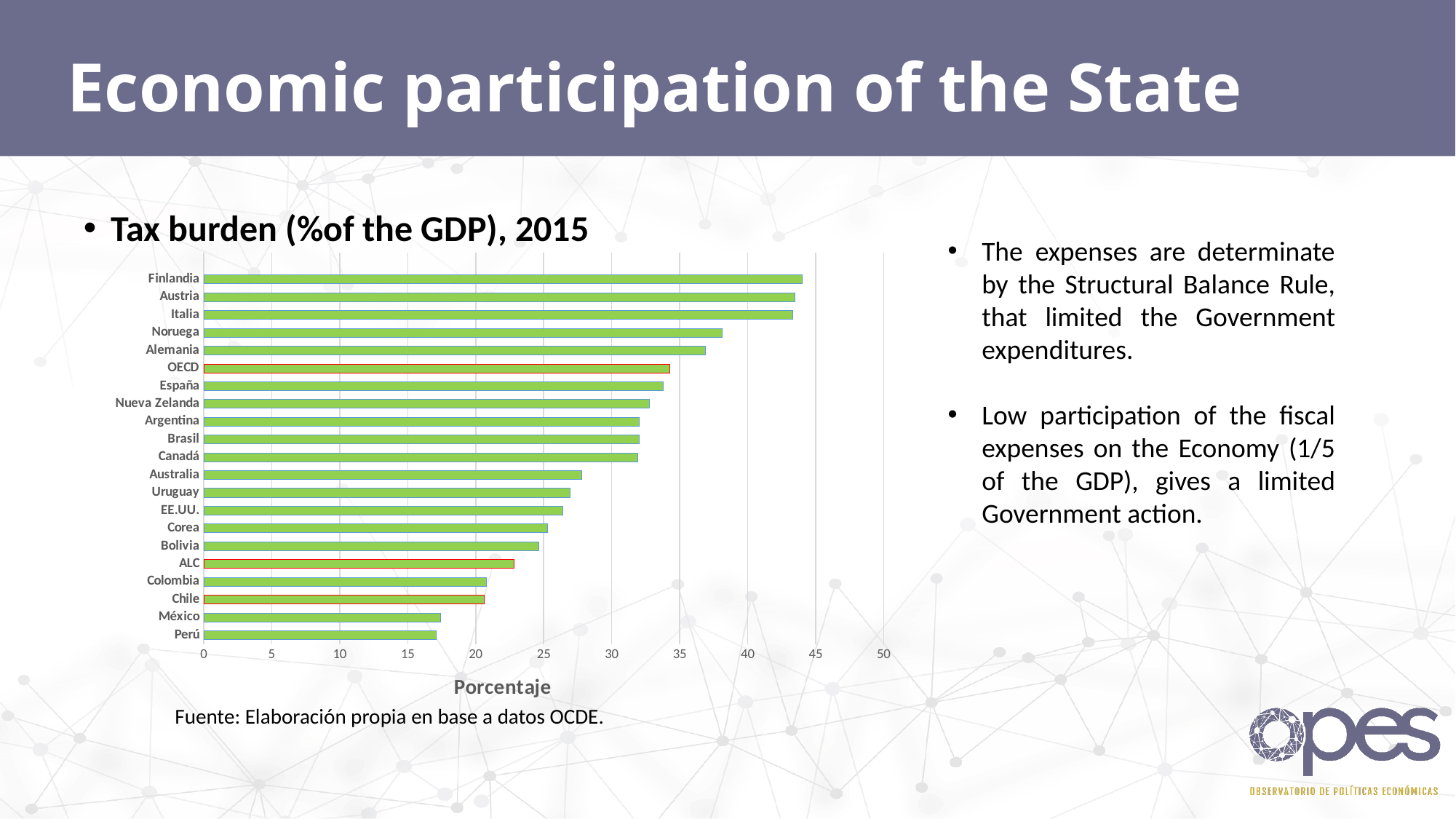
Which category has the highest tax burden in the chart? Finlandia Is the value for Perú greater or less than 20? less Which two bars are outlined in red? OECD and ALC Is the value for ALC greater or less than 20? greater Is the value for Australia greater or less than 30? less What kind of chart is shown on the slide? bar chart How many countries or groups are listed on the chart? 21 Which has a higher tax burden, OECD or ALC? OECD What is the label of the horizontal axis? Porcentaje Which has a higher tax burden, Noruega or Australia? Noruega